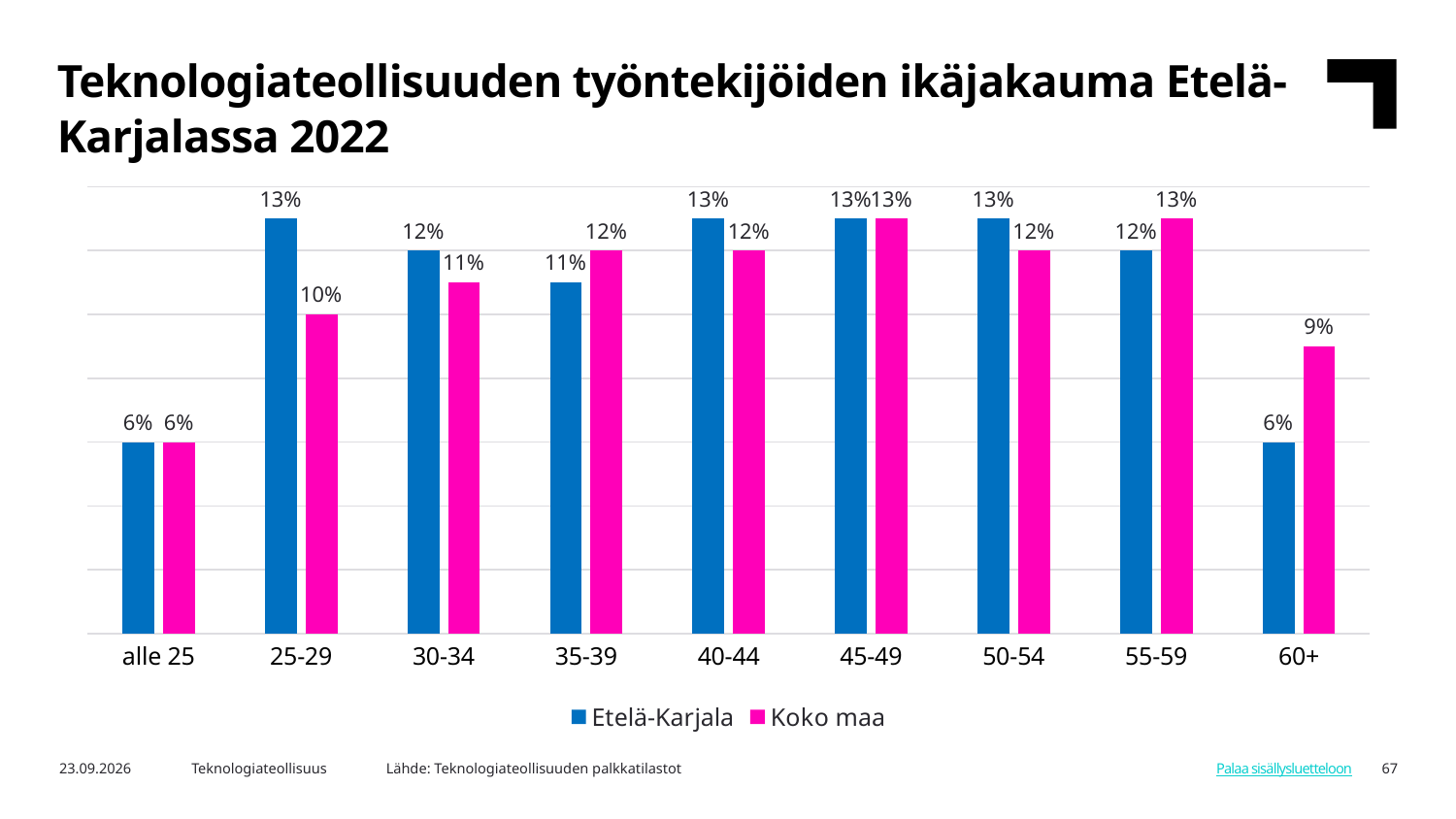
In the 60+ age group, which series has the larger value, Etelä-Karjala or Koko maa? Koko maa In the 25-29 age group, which series has the larger value, Etelä-Karjala or Koko maa? Etelä-Karjala Which age group has the lowest value for Koko maa? alle 25 How many age groups are shown on the x axis? 9 What is the value for Etelä-Karjala in the 25-29 age group? 13% What is the difference between the Etelä-Karjala and Koko maa values in the 25-29 age group? 3 percentage points What kind of chart is shown on the slide? Bar chart How many series does the legend list? 2 What is the value for Koko maa in the 30-34 age group? 11% What is the value for Koko maa in the 60+ age group? 9% What is the difference between the Koko maa and Etelä-Karjala values in the 60+ age group? 3 percentage points What is the value for Etelä-Karjala in the 35-39 age group? 11%